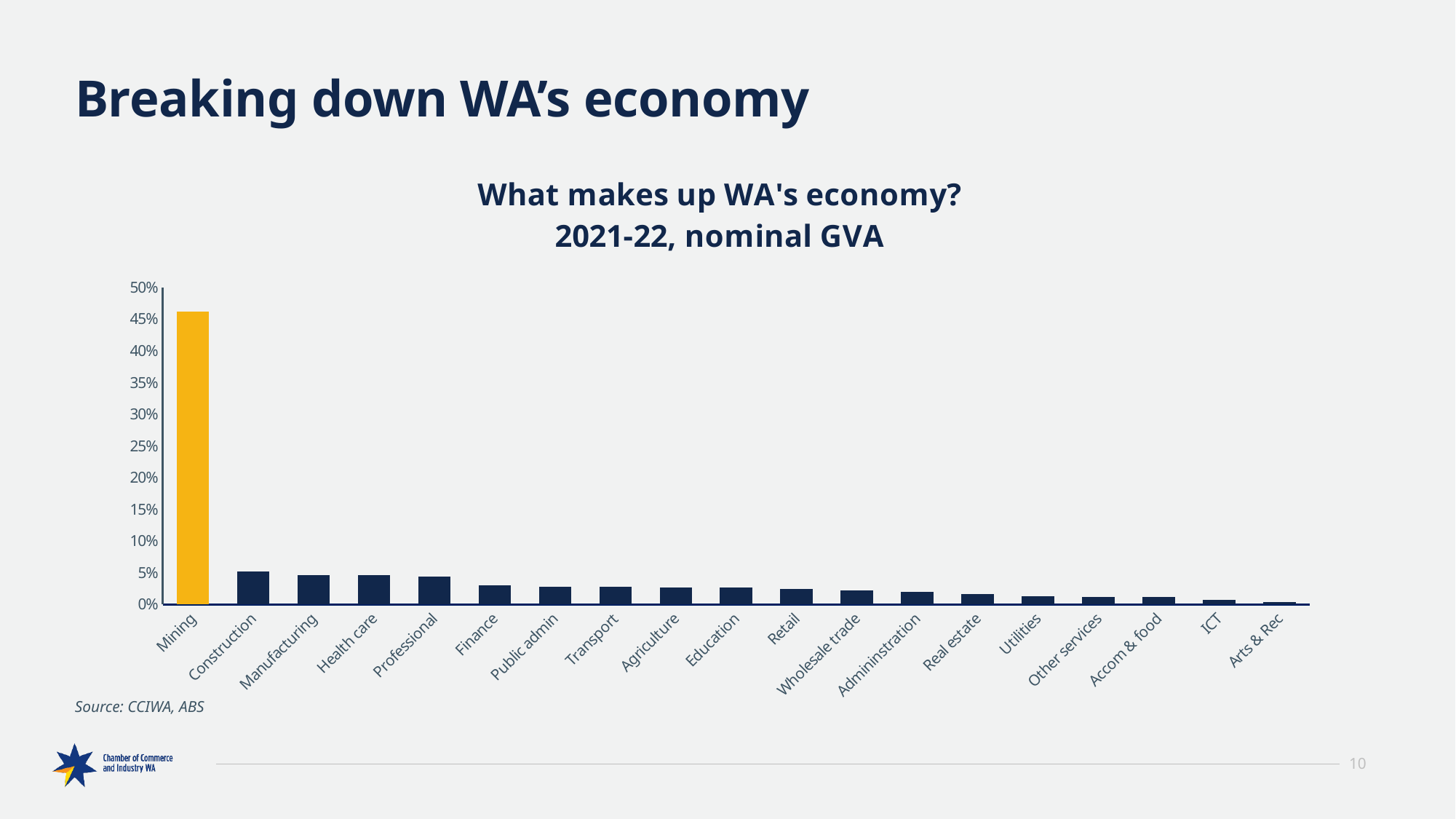
Which is larger, the value for Health care or the value for ICT? Health care Which industry has the highest share of WA's economy in the chart? Mining Is the value for Mining greater or less than 40%? greater Which is larger, the value for Mining or the value for Construction? Mining What kind of chart is shown on the slide? Bar chart Which industry has the lowest share of WA's economy in the chart? Arts & Rec What is the title of the chart? What makes up WA's economy? 2021-22, nominal GVA How many industries are shown on the x axis of the chart? 19 Is the value for Mining greater or less than 50%? less Do the bar values rise or fall moving from left to right along the x axis? Fall Is the value for Finance greater or less than 5%? less